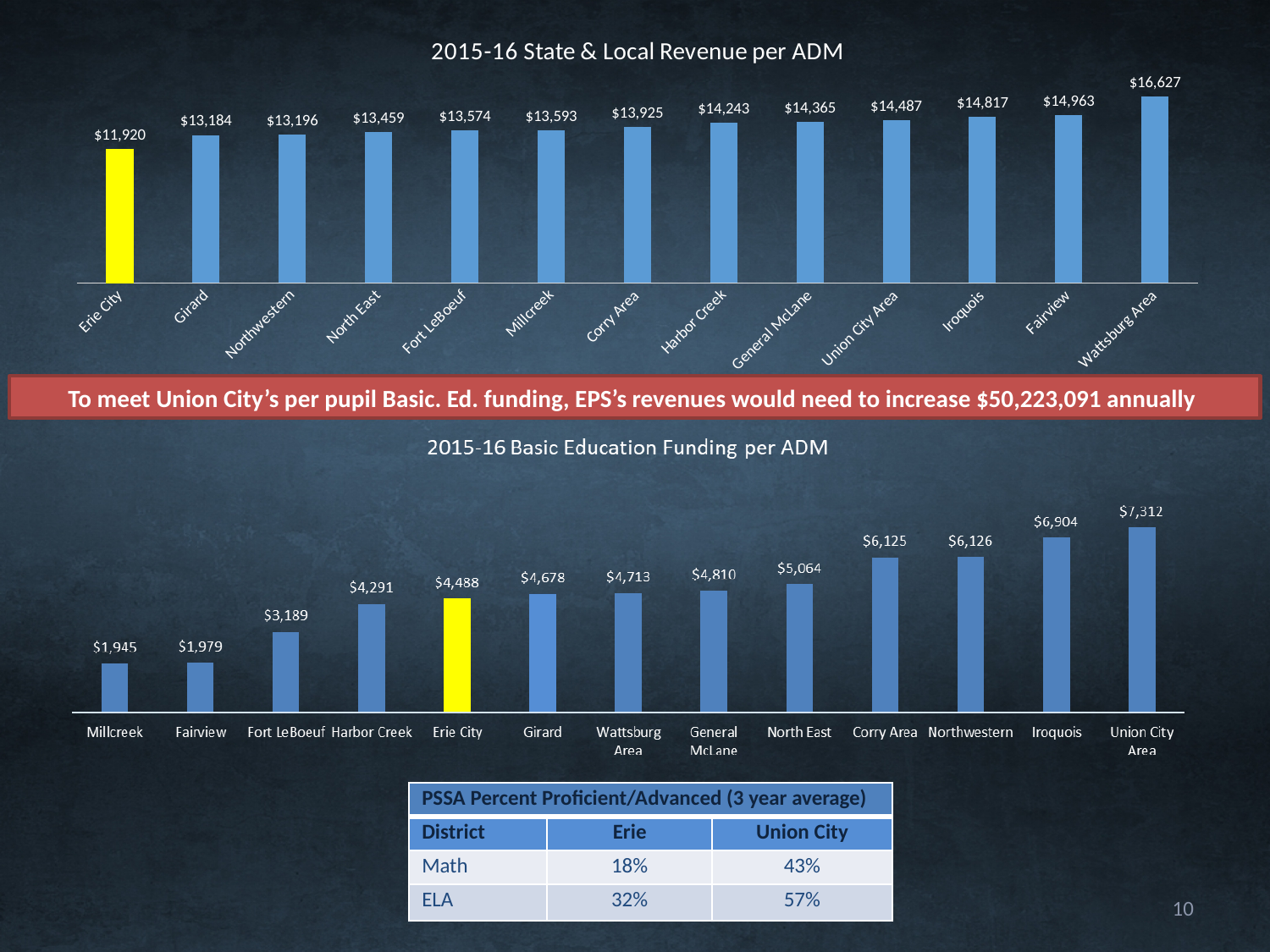
In the '2015-16 State & Local Revenue per ADM' chart, which district has the highest value? Wattsburg Area In the '2015-16 State & Local Revenue per ADM' chart, which district has the lowest value? Erie City In the '2015-16 Basic Education Funding per ADM' chart, what is the difference between Union City Area and Erie City? $2,824 In the '2015-16 Basic Education Funding per ADM' chart, which district has the lowest value? Millcreek What type of chart is the '2015-16 Basic Education Funding per ADM' chart? bar chart In the '2015-16 State & Local Revenue per ADM' chart, what is the value for Harbor Creek? $14,243 In the '2015-16 State & Local Revenue per ADM' chart, how many districts are shown? 13 In the '2015-16 Basic Education Funding per ADM' chart, which is larger, Fort LeBoeuf or Harbor Creek? Harbor Creek In the '2015-16 Basic Education Funding per ADM' chart, do the values rise or fall from left to right? rise In the '2015-16 State & Local Revenue per ADM' chart, what is the difference between Union City Area and Erie City? $2,567 In the '2015-16 Basic Education Funding per ADM' chart, what is the value for Union City Area? $7,312 In the '2015-16 State & Local Revenue per ADM' chart, what is the value for Erie City? $11,920